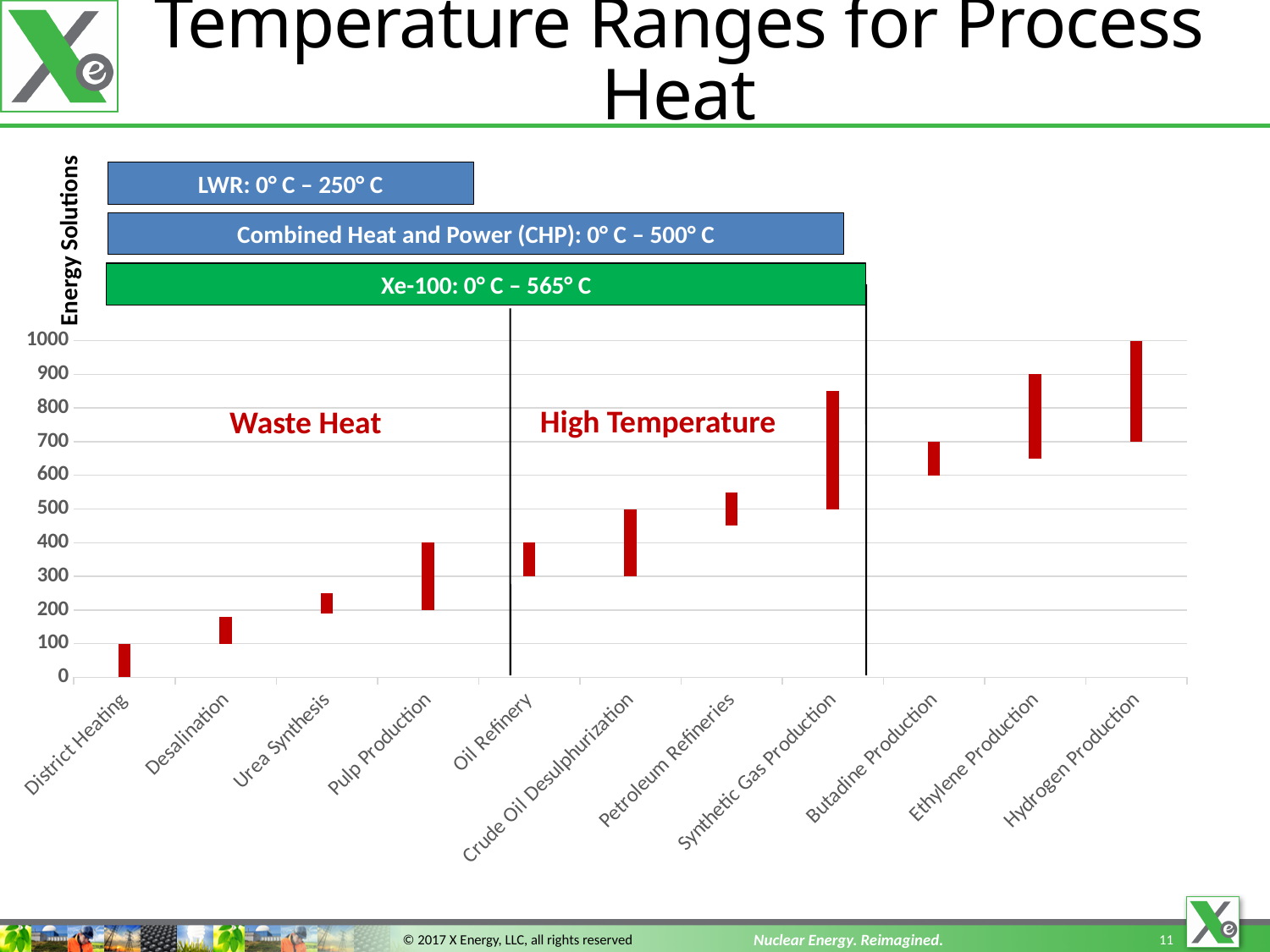
Which process has the highest upper temperature in the chart? Hydrogen Production What is the upper end of the temperature range for Pulp Production? 400 What kind of chart is shown on the slide? bar chart Is the upper end of the range for Desalination greater or less than 200? less Which process has the lowest temperature range in the chart? District Heating How many process categories are shown along the x axis of the chart? 11 Is the upper end of the range for Synthetic Gas Production greater or less than 800? greater Do the temperature ranges generally rise or fall moving from left to right along the x axis? rise What is the upper end of the temperature range for Hydrogen Production? 1000 What is the lower end of the temperature range for Butadine Production? 600 Which has a higher upper temperature, Ethylene Production or Butadine Production? Ethylene Production What temperature range does the green Xe-100 bar above the chart state? 0° C – 565° C